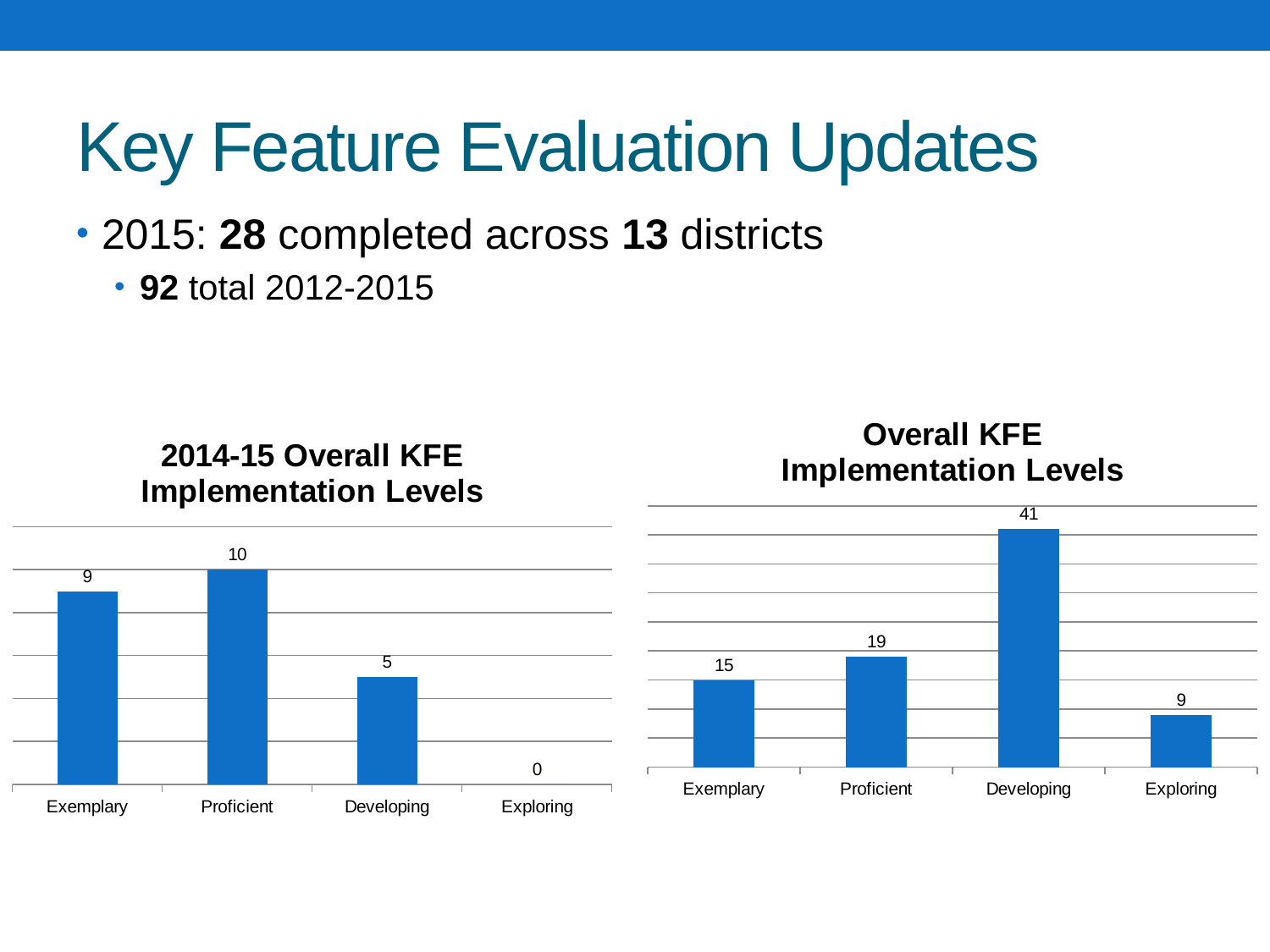
In the 'Overall KFE Implementation Levels' chart on the right, what is the value for Exemplary? 15 In the 'Overall KFE Implementation Levels' chart on the right, which category has the lowest value? Exploring How many categories are shown in the '2014-15 Overall KFE Implementation Levels' chart? 4 In the '2014-15 Overall KFE Implementation Levels' chart, what is the value for Exploring? 0 What is the title of the chart on the left side of the slide? 2014-15 Overall KFE Implementation Levels In the '2014-15 Overall KFE Implementation Levels' chart, which category has the highest value? Proficient What kind of chart is the 'Overall KFE Implementation Levels' chart on the right? Bar chart In the 'Overall KFE Implementation Levels' chart on the right, what is the value for Developing? 41 In the '2014-15 Overall KFE Implementation Levels' chart, what is the value for Proficient? 10 In the 'Overall KFE Implementation Levels' chart on the right, what is the difference between Developing and Proficient? 22 In the '2014-15 Overall KFE Implementation Levels' chart, what is the difference between Exemplary and Developing? 4 In the 'Overall KFE Implementation Levels' chart on the right, which is larger, Exemplary or Proficient? Proficient